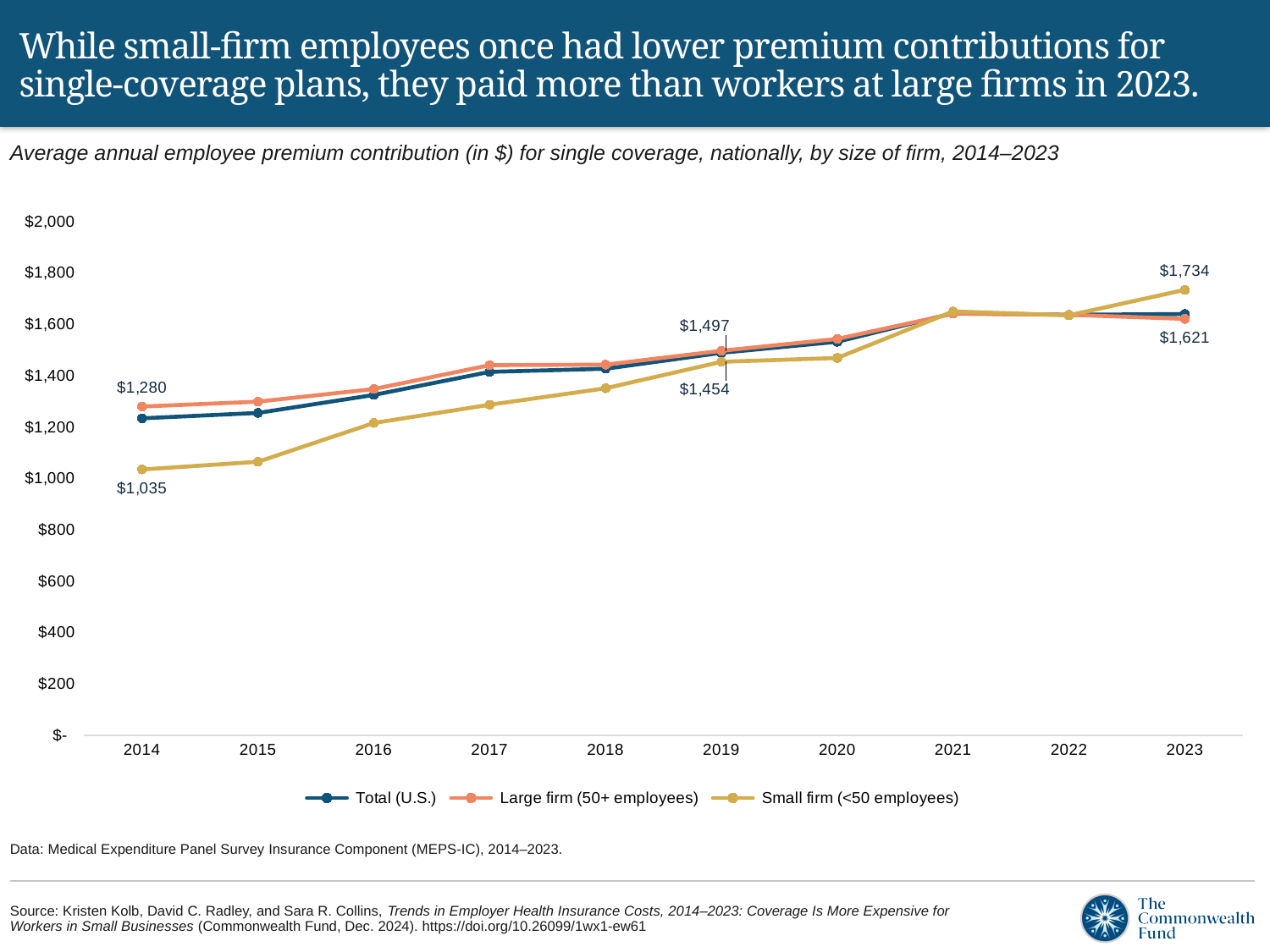
In 2019, which was larger: the large-firm contribution or the small-firm contribution? Large firm (50+ employees) How many series does the legend list? 3 Does the small-firm premium contribution rise or fall from 2014 to 2023? rise How many years are shown on the x axis? 10 What was the average annual employee premium contribution for small firms (<50 employees) in 2014? $1,035 What kind of chart is shown on the slide? line chart What was the average annual employee premium contribution for large firms (50+ employees) in 2023? $1,621 What was the average annual employee premium contribution for small firms (<50 employees) in 2023? $1,734 What is the difference between the large-firm and small-firm premium contributions in 2014? $245 Is the small-firm premium contribution in 2016 greater or less than $1,400? less What was the average annual employee premium contribution for large firms (50+ employees) in 2014? $1,280 What is the difference between the small-firm and large-firm premium contributions in 2023? $113